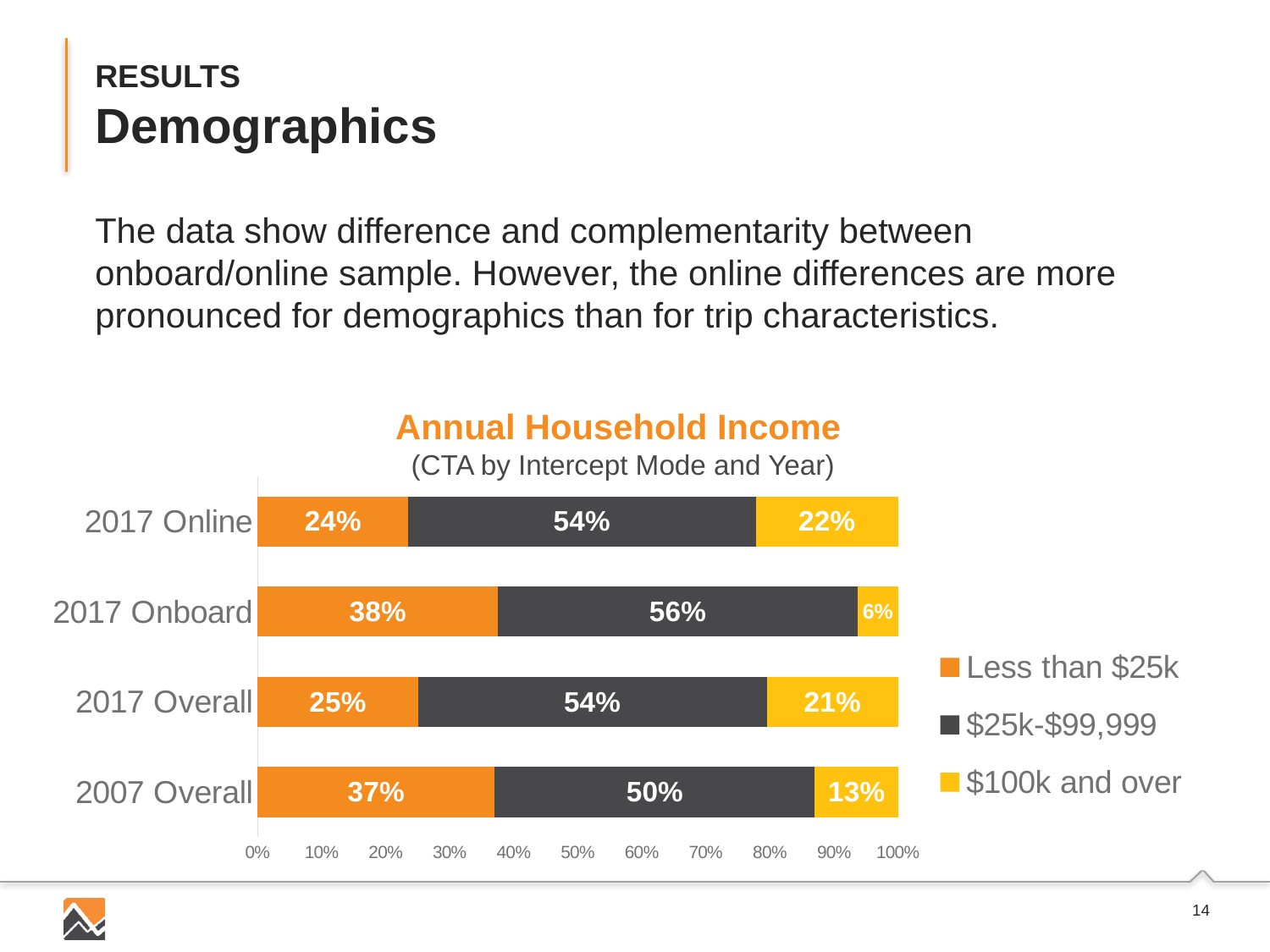
What kind of chart is shown on the slide? Stacked bar chart What is the difference between the Less than $25k values for 2017 Onboard and 2017 Online? 14 percentage points Which category has the highest value for $100k and over? 2017 Online How many categories (bars) are shown on the chart? 4 What is the title of the chart? Annual Household Income Which is larger: the $100k and over value for 2017 Overall or for 2007 Overall? 2017 Overall What percentage of 2017 Onboard respondents reported household income of less than $25k? 38% What share of 2007 Overall respondents fall in the $25k-$99,999 category? 50% Which category has the lowest value for $100k and over? 2017 Onboard How many series does the legend list? 3 What is the value for $100k and over in the 2017 Online bar? 22% What is the total of the 2017 Onboard stacked bar? 100%